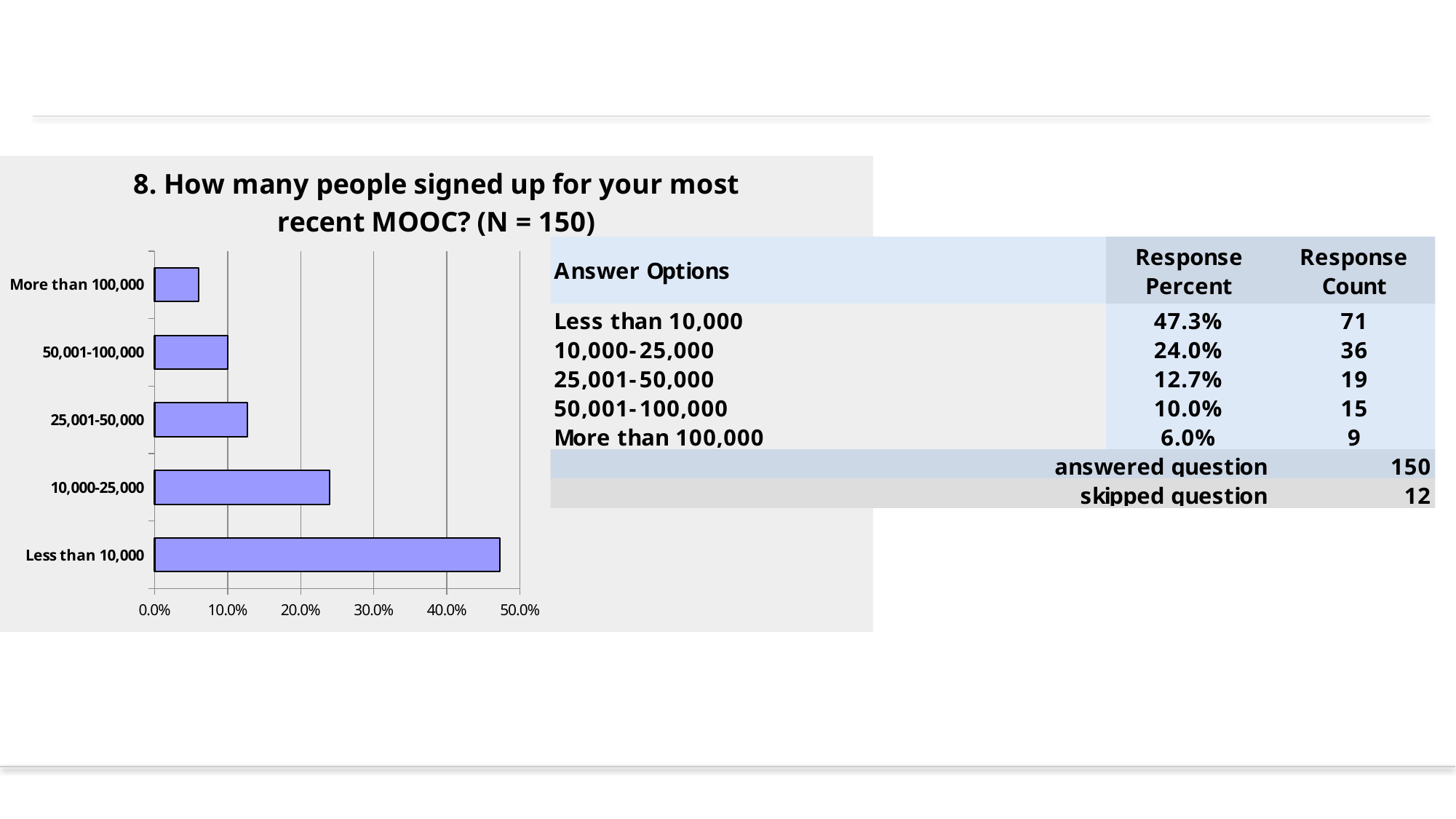
Is the value for 10,000-25,000 greater or less than 20.0%? greater What is the response count for 10,000-25,000? 36 Which category has the lowest response percent? More than 100,000 What is the title of the chart? 8. How many people signed up for your most recent MOOC? (N = 150) Which is larger, the value for 25,001-50,000 or the value for 50,001-100,000? 25,001-50,000 What kind of chart is shown on the slide? bar chart What is the response percent for Less than 10,000? 47.3% What is the difference in response percent between Less than 10,000 and 10,000-25,000? 23.3% What is the response percent for 50,001-100,000? 10.0% How many categories does the bar chart show? 5 Which category has the highest response percent? Less than 10,000 Is the value for More than 100,000 greater or less than 10.0%? less